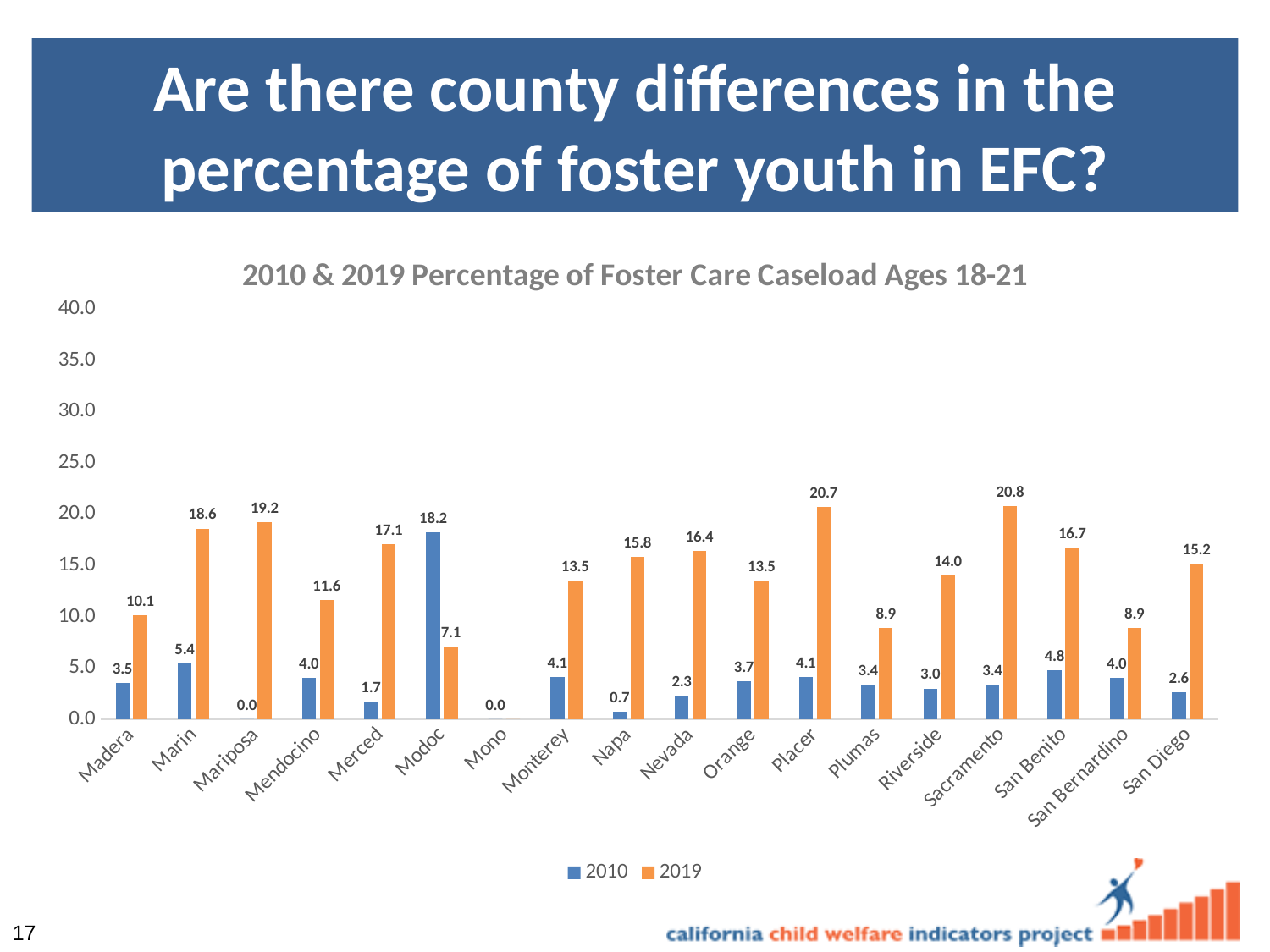
Which county has the highest 2010 value? Modoc What kind of chart is shown on the slide? Bar chart What is the difference between the 2019 and 2010 values for Placer? 16.6 For Modoc, which year has the larger value, 2010 or 2019? 2010 What is the 2010 value for Modoc? 18.2 What is the 2019 value for Marin? 18.6 How many counties are shown on the x axis? 18 How many series does the legend list? 2 Which has a larger 2019 value, Mariposa or Merced? Mariposa What is the difference between the 2019 and 2010 values for Madera? 6.6 Is the 2019 value for Sacramento greater or less than 20.0? greater What is the 2010 value for Napa? 0.7